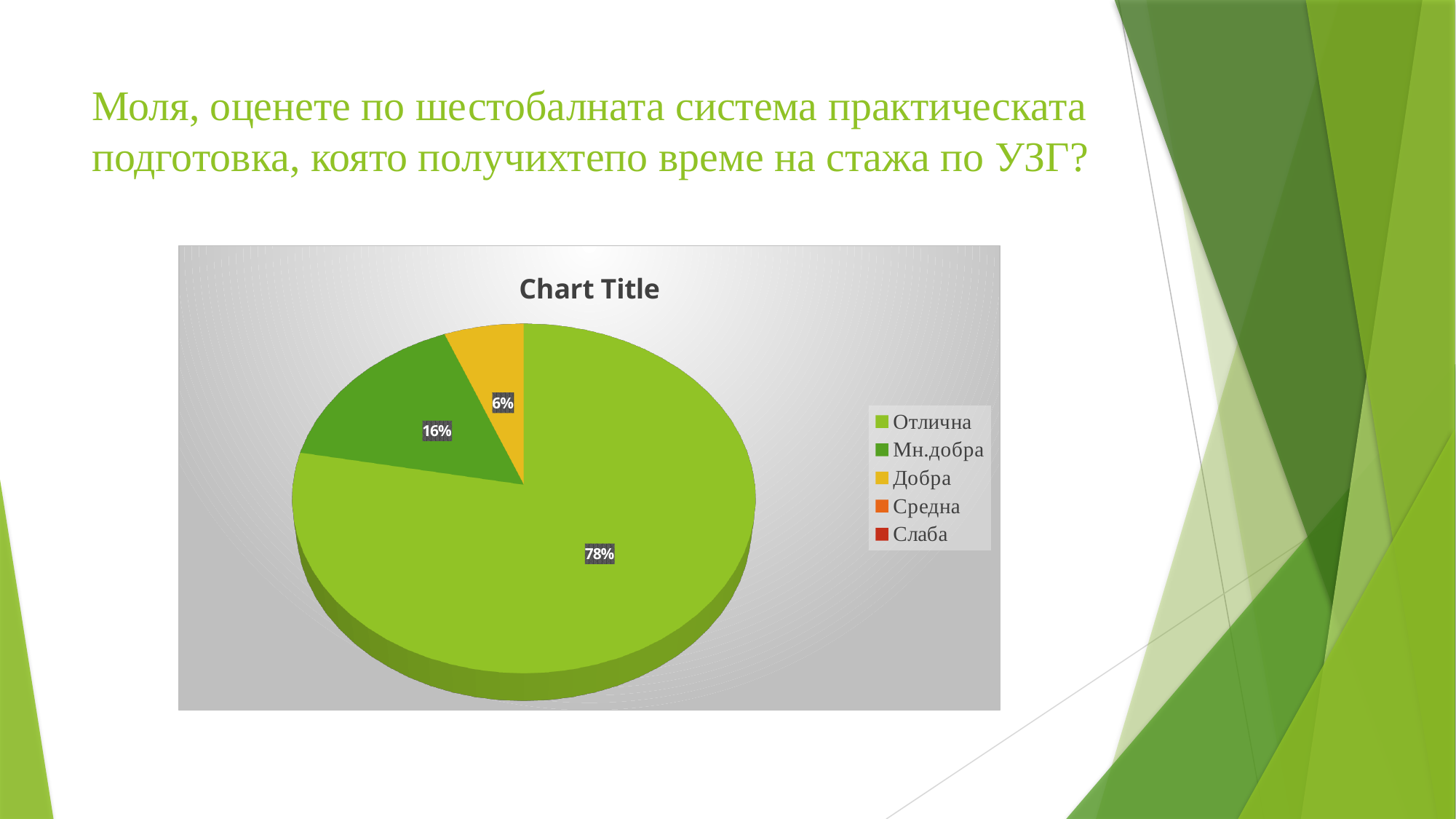
What is the difference between the shares of Отлична and Мн.добра? 62% What is the title of the chart? Chart Title What share of the pie does Отлична have? 78% What kind of chart is shown on the slide? pie chart Which category has the largest slice of the pie? Отлична Which of the labelled slices is the smallest? Добра What share of the pie does Добра have? 6% What is the difference between the shares of Мн.добра and Добра? 10% What colour is the slice for Добра? yellow How many entries does the legend list? 5 Which is larger, the slice for Мн.добра or the slice for Добра? Мн.добра What share of the pie does Мн.добра have? 16%